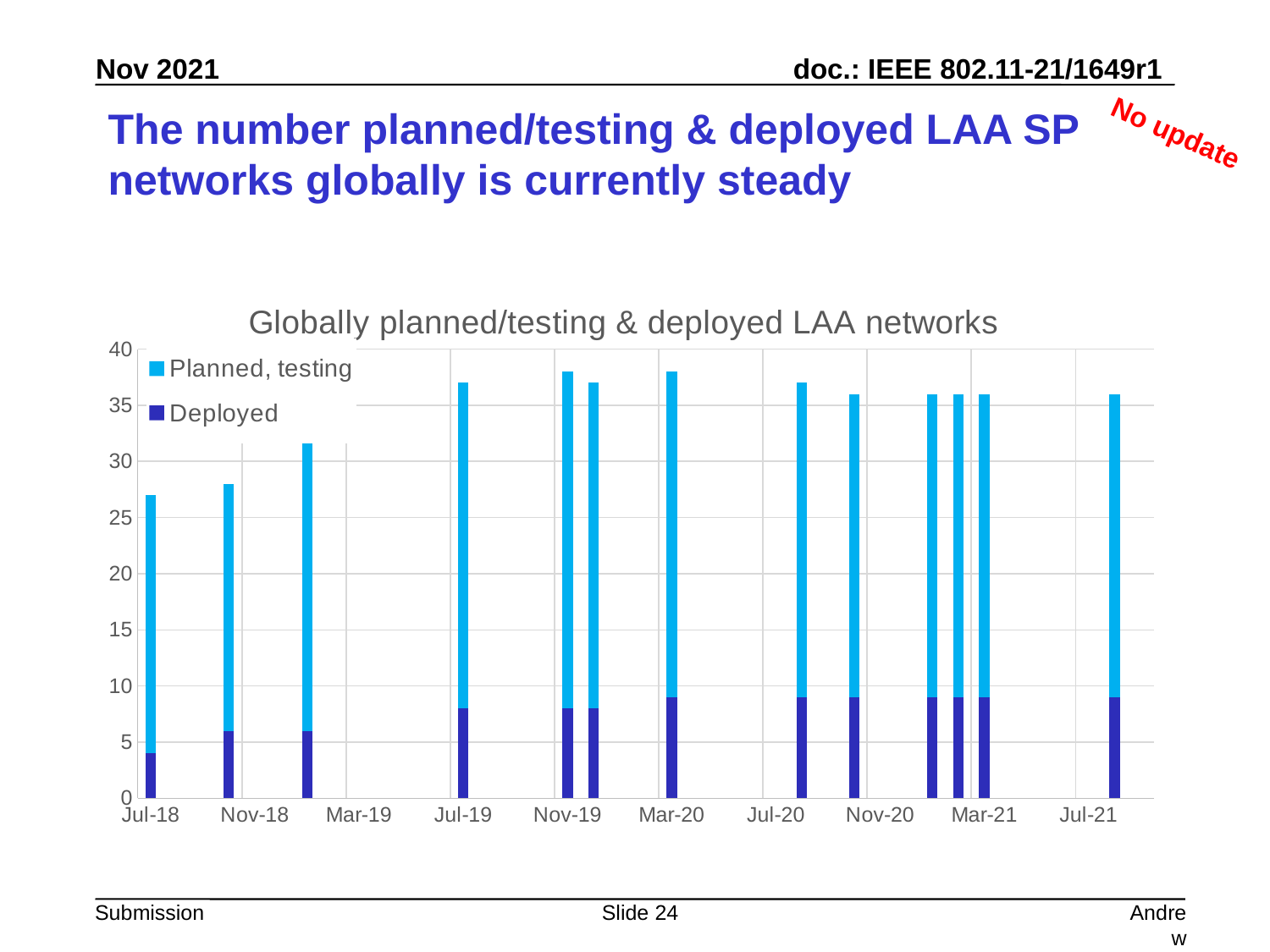
Which bar has a larger total, Jul-18 or Jul-19? Jul-19 What kind of chart is shown on the slide? Stacked bar chart Is the Deployed value at Jul-18 greater or less than 5? less How many series does the legend list? 2 Which has the larger Deployed value, Jul-18 or Mar-20? Mar-20 Is the total value of the bar at Jul-19 greater or less than 35? greater Is the total value of the bar at Jul-18 greater or less than 30? less What are the two series named in the legend? Planned, testing; Deployed What is the title of the chart? Globally planned/testing & deployed LAA networks Do the total bar heights rise or fall from Jul-18 to Jul-19? rise How many bars are plotted in the chart? 13